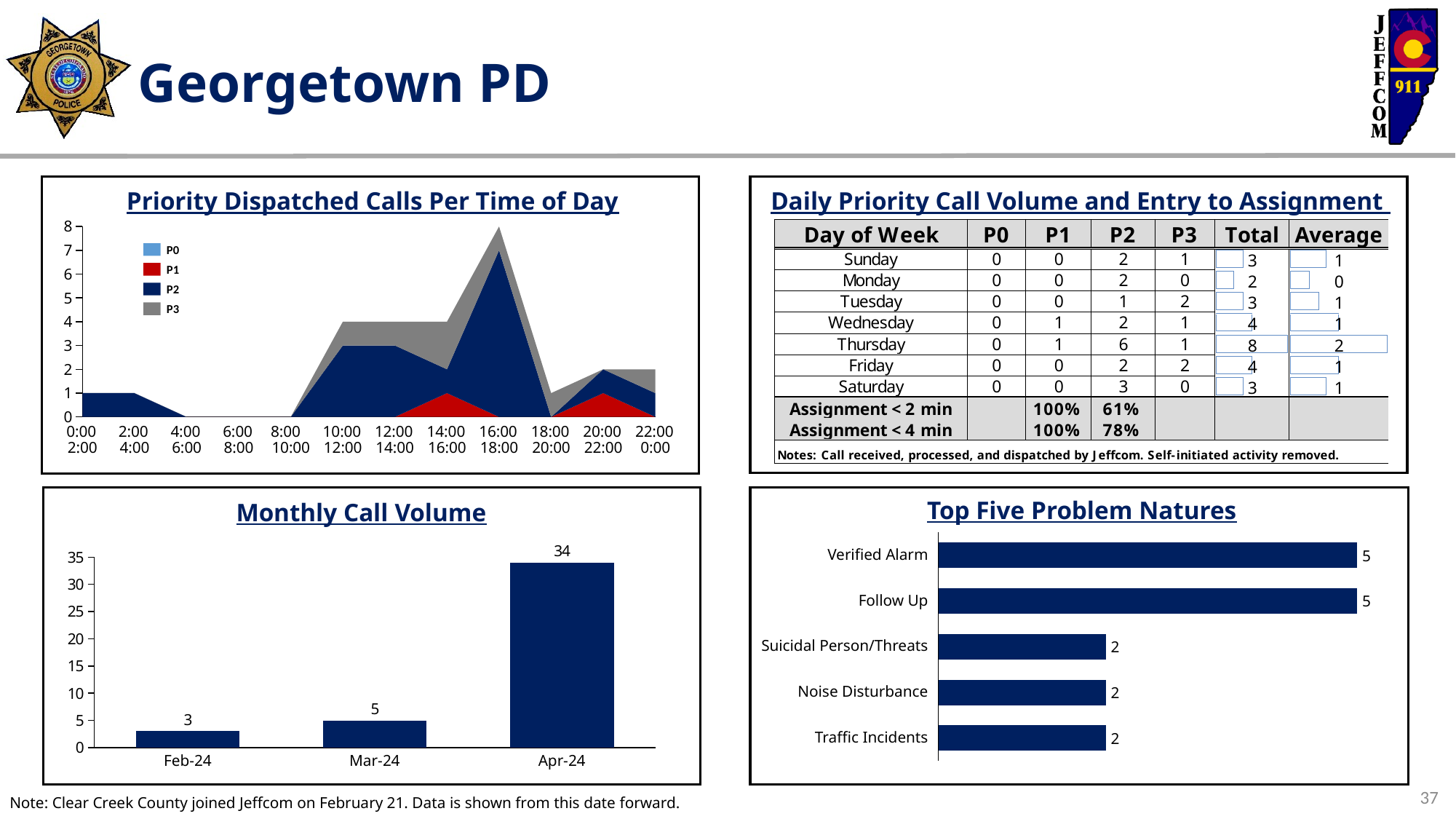
In the Top Five Problem Natures chart, how many problem natures are listed? 5 In the Top Five Problem Natures chart, which is larger, Follow Up or Noise Disturbance? Follow Up In the Monthly Call Volume chart, what is the value for Apr-24? 34 In the Monthly Call Volume chart, do the values rise or fall from Feb-24 to Apr-24? rise In the Monthly Call Volume chart, what is the difference between the Apr-24 and Mar-24 values? 29 What kind of chart is the Monthly Call Volume chart? bar chart In the Top Five Problem Natures chart, what is the value for Verified Alarm? 5 In the Priority Dispatched Calls Per Time of Day chart, is the total value for the 16:00-18:00 period greater or less than 4? greater In the Monthly Call Volume chart, what is the value for Feb-24? 3 In the Priority Dispatched Calls Per Time of Day chart, how many series does the legend list? 4 In the Monthly Call Volume chart, which month has the highest call volume? Apr-24 In the Top Five Problem Natures chart, what is the value for Suicidal Person/Threats? 2